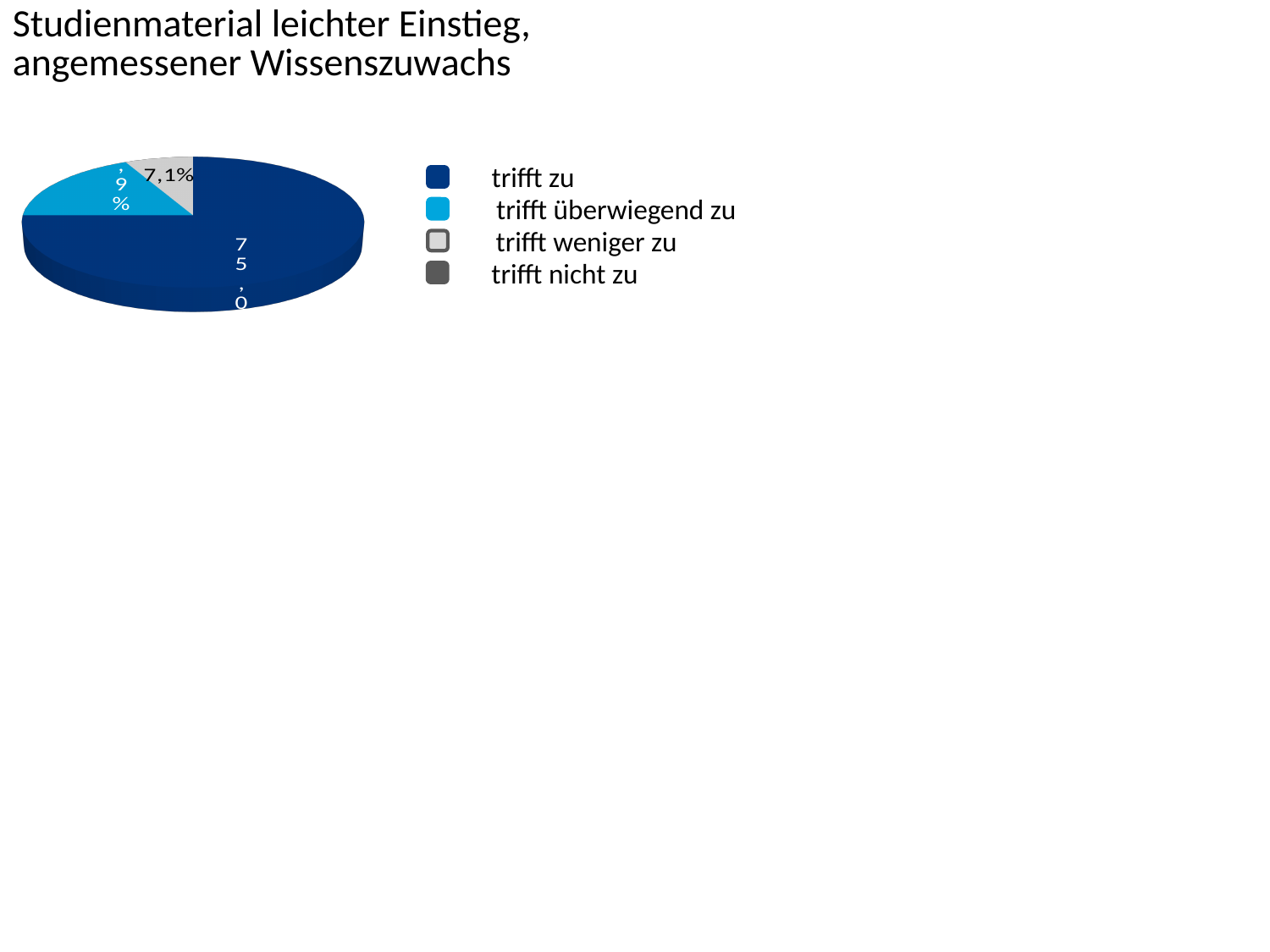
What colour represents "trifft zu" in the pie chart? dark blue What is the title of the slide? Studienmaterial leichter Einstieg, angemessener Wissenszuwachs What kind of chart is shown on the slide? pie chart What share of the pie does "trifft weniger zu" have? 7,1% What share of the pie does "trifft zu" have? 75,0% How many entries does the legend list? 4 Which is larger, the slice for "trifft überwiegend zu" or the slice for "trifft weniger zu"? trifft überwiegend zu Which category has the largest slice of the pie? trifft zu What is the difference between the shares of "trifft zu" and "trifft weniger zu"? 67,9 percentage points How many slices are visible in the pie? 3 Which of the slices shown in the pie is the smallest? trifft weniger zu Which is larger, the slice for "trifft zu" or the slice for "trifft weniger zu"? trifft zu